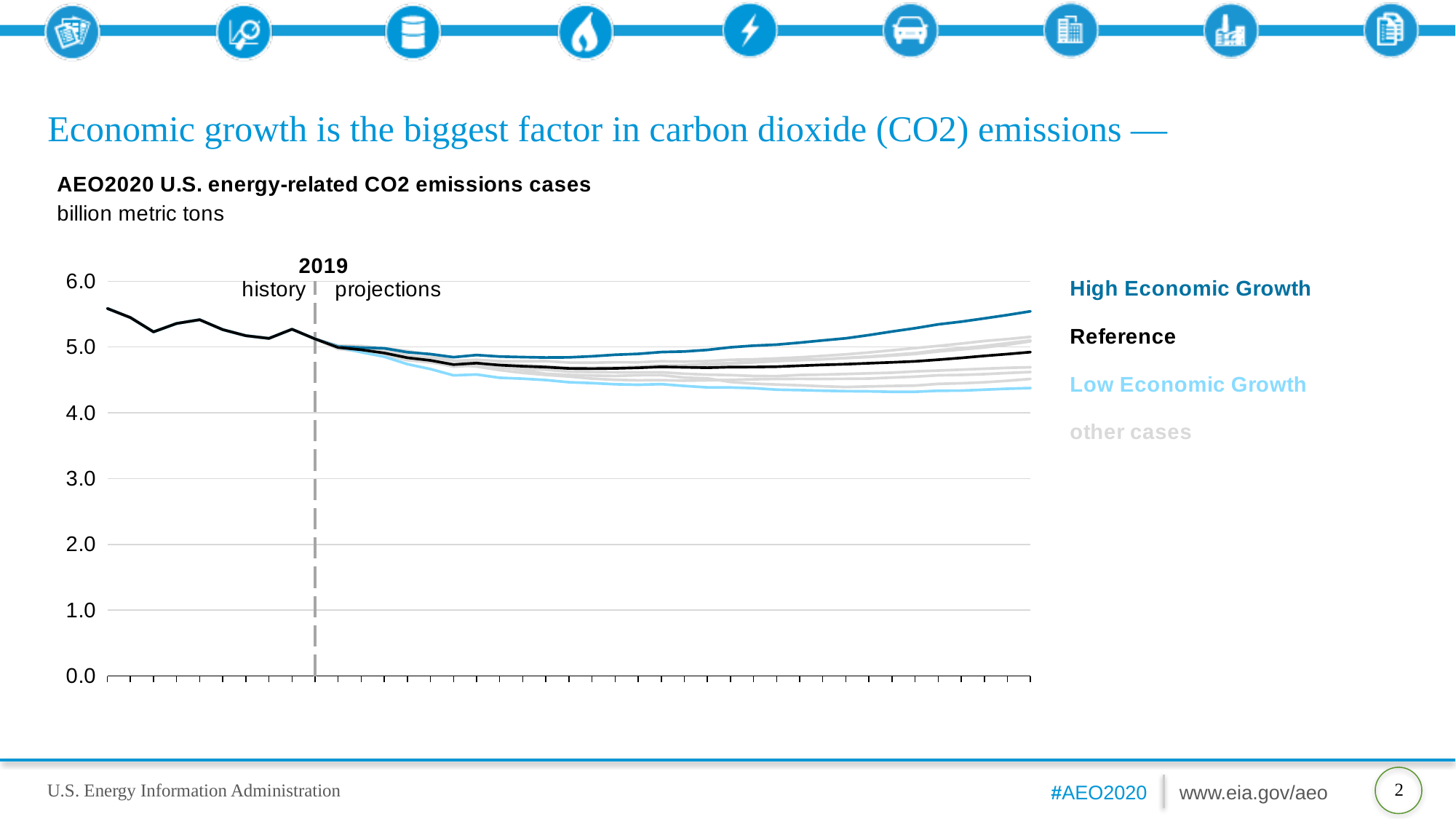
Which case has the highest emissions at the end of the projection period? High Economic Growth How many entries does the legend list? 4 Which case has the lowest emissions at the end of the projection period? Low Economic Growth Does the Low Economic Growth line rise or fall from 2019 to the end of the projection period? fall At the end of the projection period, is the value for High Economic Growth greater or less than 5.0? greater At the end of the projection period, which is larger: the High Economic Growth case or the Low Economic Growth case? High Economic Growth What is the title of the chart? AEO2020 U.S. energy-related CO2 emissions cases At the end of the projection period, is the value for Reference greater or less than 4.0? greater What unit is the y axis measured in? billion metric tons Does the High Economic Growth line rise or fall over the second half of the projection period? rise At the end of the projection period, is the value for Low Economic Growth greater or less than 5.0? less What kind of chart is shown on the slide? line chart